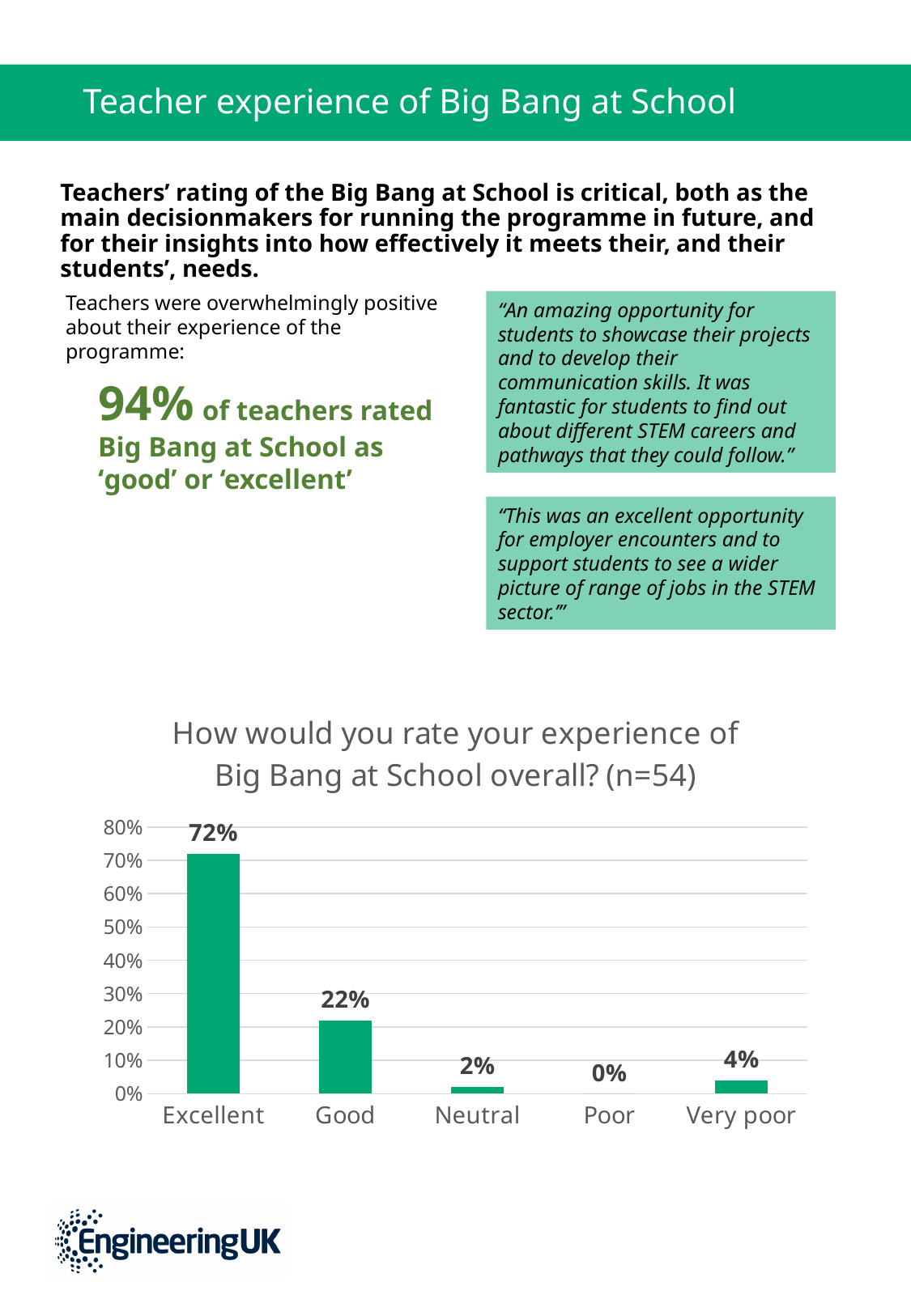
What percentage of teachers rated their experience as Good? 22% Which rating category has the lowest value? Poor What is the value shown for the Neutral category? 2% Which rating category has the highest value? Excellent Which is larger, the value for Neutral or the value for Very poor? Very poor What kind of chart is used to show the teacher ratings? Bar chart What is the value shown for the Very poor category? 4% Is the value for Good greater or less than 30%? less What is the difference between the Excellent and Good percentages? 50% What is the sample size (n) given in the chart title? 54 What percentage of teachers rated their experience of Big Bang at School as Excellent? 72% How many rating categories are shown on the x axis? 5